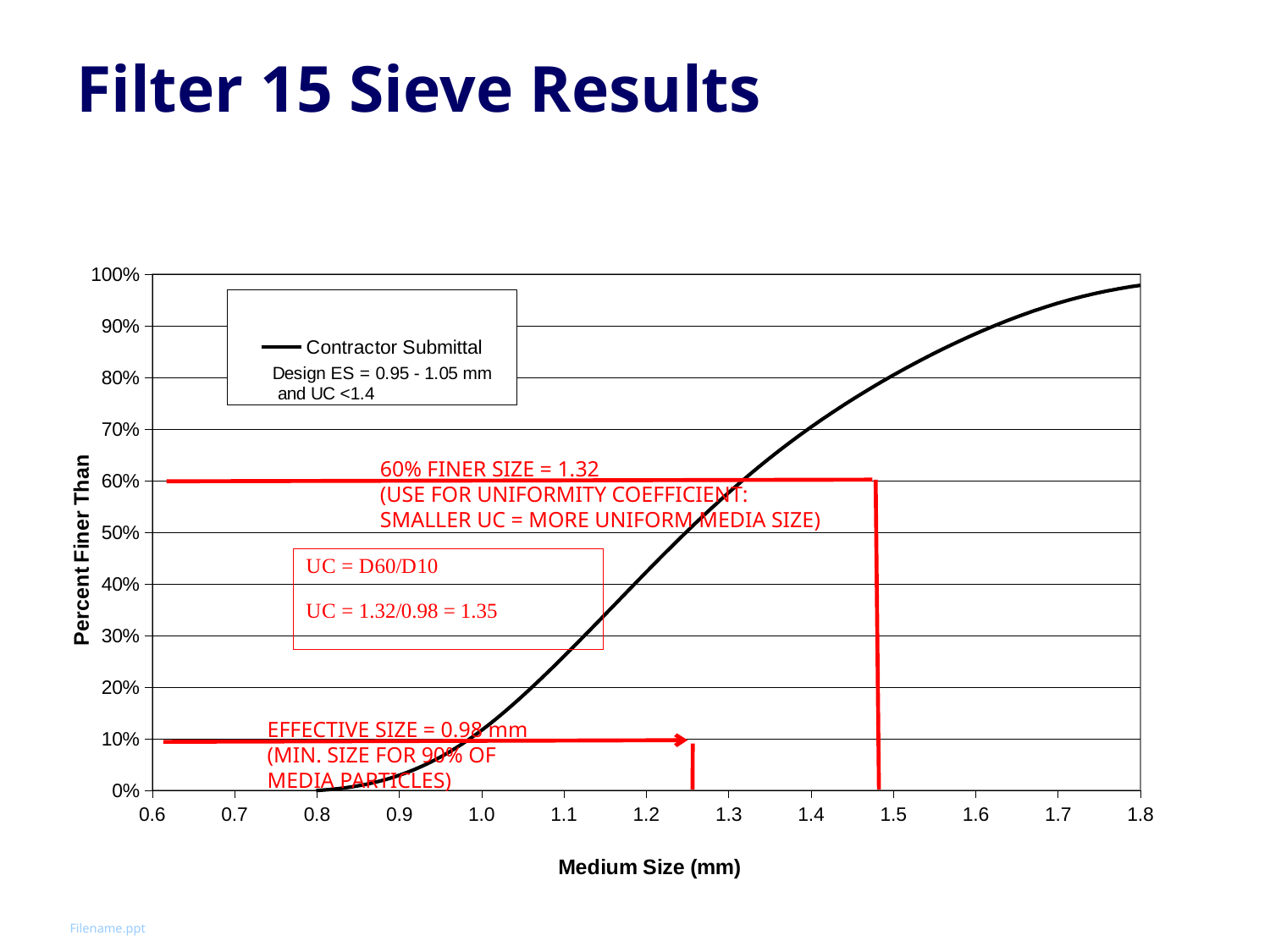
What is the label of the x axis? Medium Size (mm) Is the Percent Finer Than value at a Medium Size of 1.8 mm greater or less than 100%? less What is the name of the series shown in the chart legend? Contractor Submittal Does the Contractor Submittal curve rise or fall as Medium Size increases? Rises What kind of chart is shown on the slide? Line chart According to the annotation, what is the 60% finer size? 1.32 Is the Percent Finer Than value at a Medium Size of 1.1 mm greater or less than 20%? greater What uniformity coefficient (UC) value is computed on the slide? 1.35 How many series does the chart legend list? 1 Is the Percent Finer Than value at a Medium Size of 0.9 mm greater or less than 10%? less According to the annotation, what is the effective size? 0.98 mm